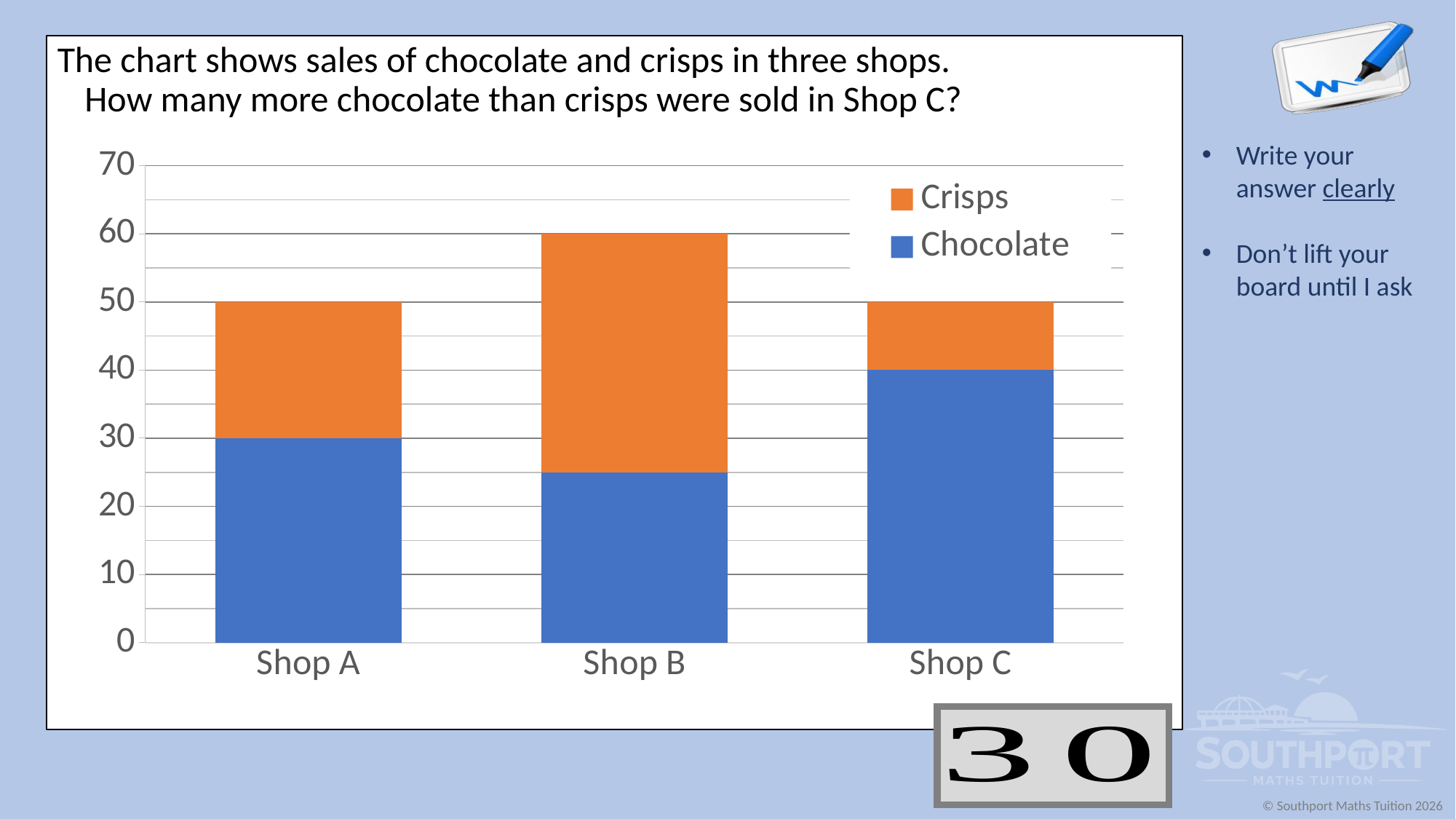
Is the chocolate value for Shop B greater or less than 30? less What is the total height of the stacked bar for Shop A? 50 Which is larger, chocolate sales in Shop A or chocolate sales in Shop C? Shop C How many more chocolate than crisps were sold in Shop C? 30 What is the chocolate sales value for Shop A? 30 Which shop has the highest total sales? Shop B How many shops are shown on the x axis? 3 What is the total height of the stacked bar for Shop B? 60 What is the chocolate sales value for Shop C? 40 Which shop has the highest chocolate sales? Shop C What kind of chart is shown on the slide? stacked bar chart How many series does the legend list? 2